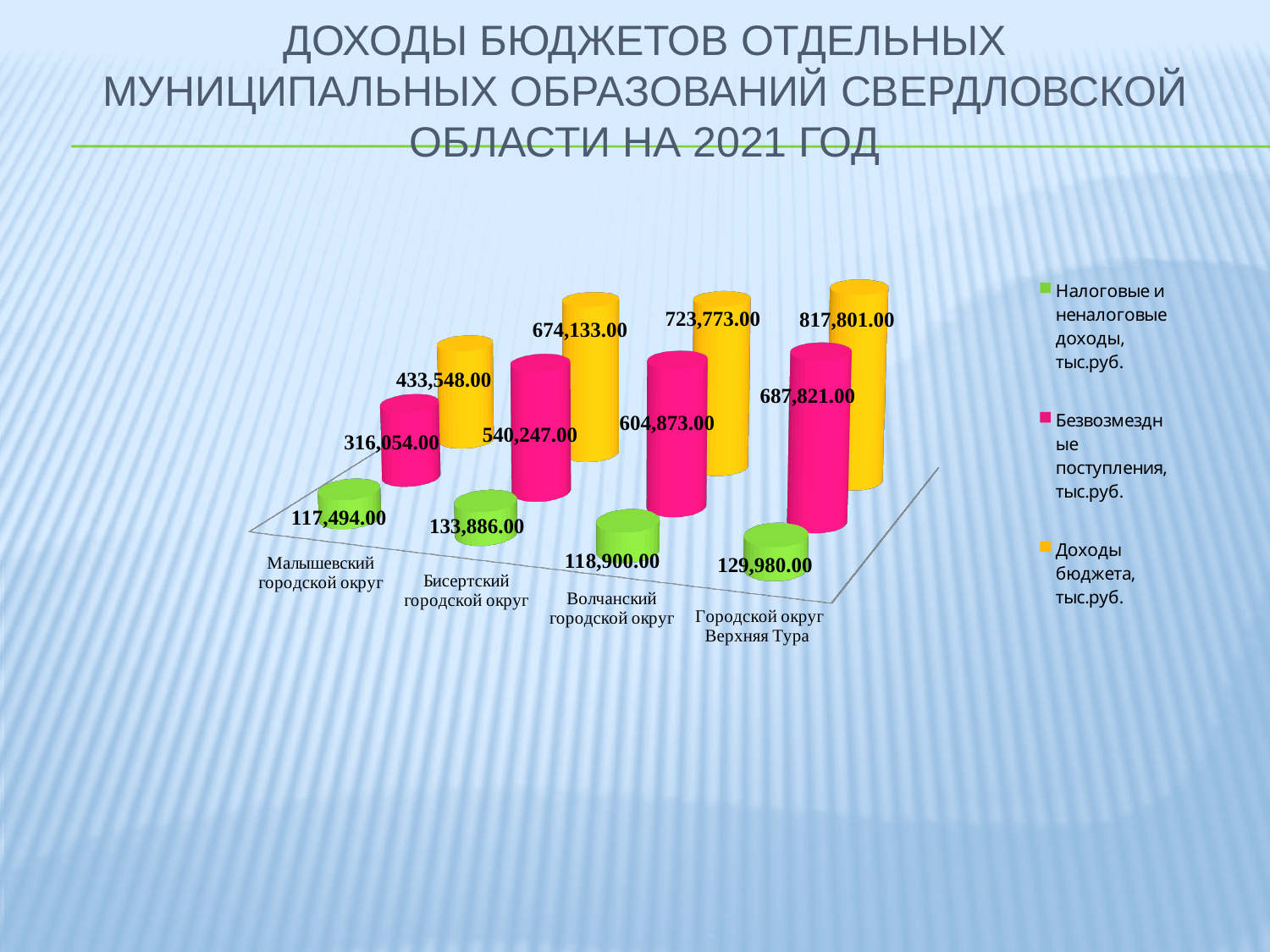
Which is larger: Безвозмездные поступления, тыс.руб. for Бисертский городской округ or for Малышевский городской округ? Бисертский городской округ Which municipality has the highest value of Доходы бюджета, тыс.руб.? Городской округ Верхняя Тура Which municipality has the lowest value of Налоговые и неналоговые доходы, тыс.руб.? Малышевский городской округ What is the value of Безвозмездные поступления, тыс.руб. for Волчанский городской округ? 604,873.00 Do the values of Доходы бюджета, тыс.руб. rise or fall from Малышевский городской округ to Городской округ Верхняя Тура? Rise What is the value of Налоговые и неналоговые доходы, тыс.руб. for Бисертский городской округ? 133,886.00 What kind of chart is shown on the slide? Bar chart How many municipalities are shown on the chart? 4 What is the value of Доходы бюджета, тыс.руб. for Городской округ Верхняя Тура? 817,801.00 How many series does the legend list? 3 Which colour represents Безвозмездные поступления, тыс.руб. in the legend? Pink What is the difference between Доходы бюджета, тыс.руб. for Волчанский городской округ and for Бисертский городской округ? 49,640.00